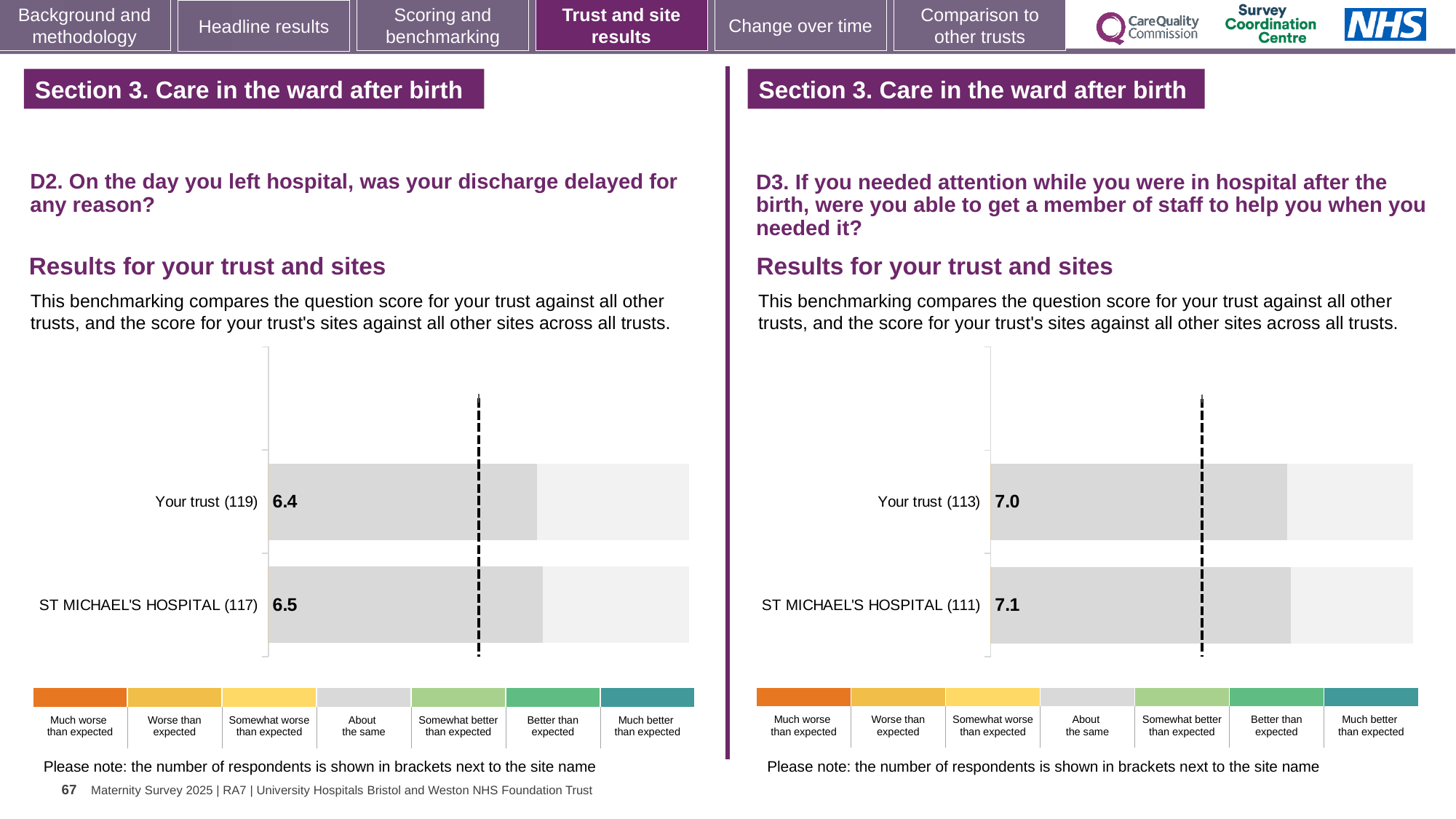
In the D2 chart on the left, what is the score for ST MICHAEL'S HOSPITAL? 6.5 In the D2 chart on the left, how many respondents are shown in brackets for Your trust? 119 In the D3 chart on the right, what is the score for ST MICHAEL'S HOSPITAL? 7.1 In the D3 chart on the right, what is the difference between the scores for ST MICHAEL'S HOSPITAL and Your trust? 0.1 In the D3 chart on the right, how many respondents are shown in brackets for ST MICHAEL'S HOSPITAL? 111 In the D2 chart on the left, what is the score for Your trust? 6.4 In the D3 chart on the right, which bar has the lowest score? Your trust How many bars are plotted in the D2 chart on the left? 2 In the D2 chart on the left, what is the difference between the scores for ST MICHAEL'S HOSPITAL and Your trust? 0.1 In the D2 chart on the left, which has the higher score, Your trust or ST MICHAEL'S HOSPITAL? ST MICHAEL'S HOSPITAL In the D3 chart on the right, what is the score for Your trust? 7.0 What type of chart is used in the D3 chart on the right? Bar chart